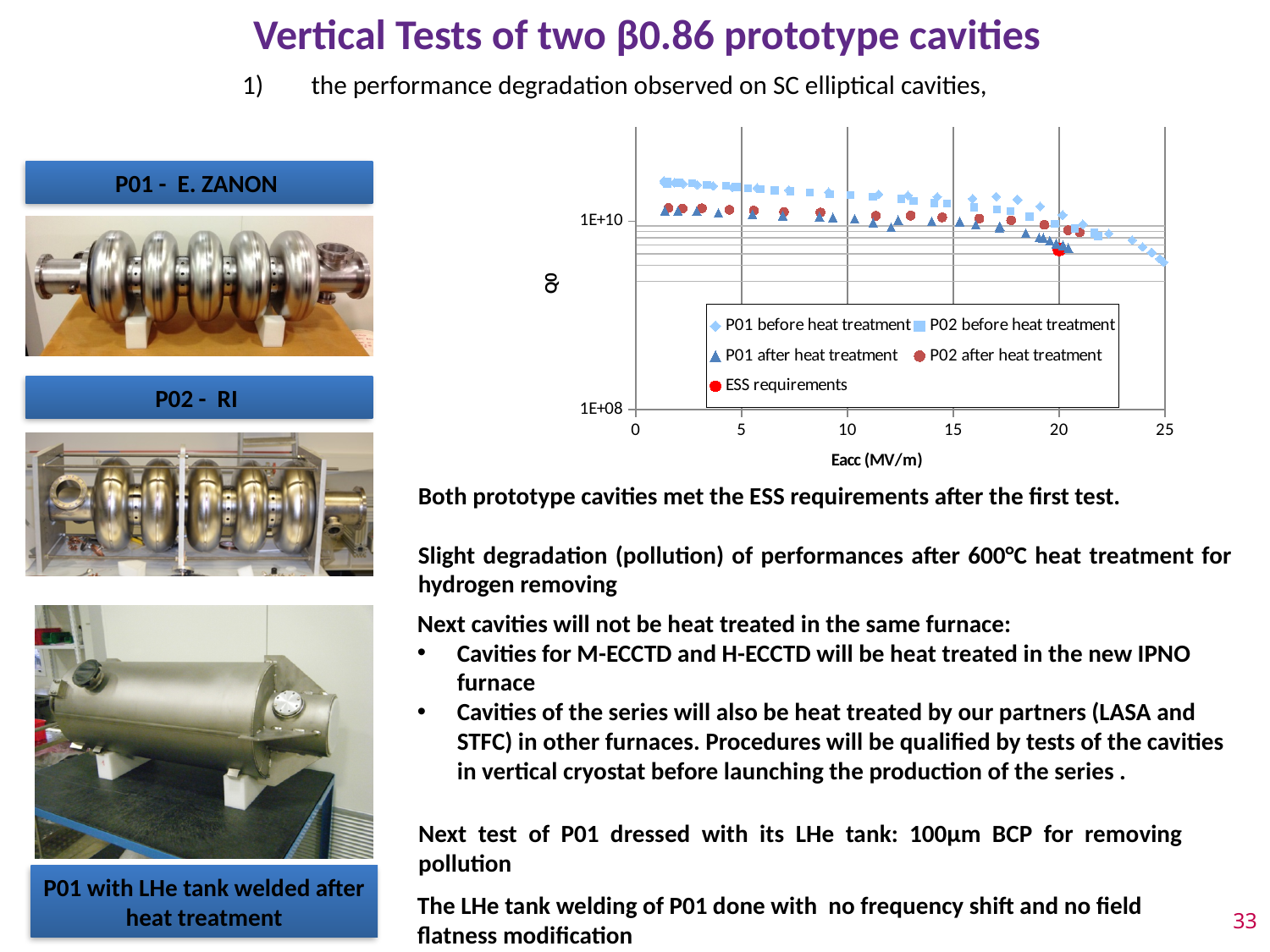
Is the Q0 value of the ESS requirements point greater or less than 1E+08? greater What is the highest Eacc value shown on the x axis of the chart? 25 At Eacc around 10 MV/m, which series has the higher Q0: P02 before heat treatment or P02 after heat treatment? P02 before heat treatment What is the label of the y axis of the chart? Q0 What kind of chart is shown on the slide? scatter chart What is the label of the x axis of the chart? Eacc (MV/m) Does Q0 rise or fall as Eacc increases for the P01 before heat treatment series? fall Is the Q0 value of the P01 before heat treatment series at Eacc 5 MV/m greater or less than 1E+10? greater At Eacc around 5 MV/m, which series has the higher Q0: P01 before heat treatment or P01 after heat treatment? P01 before heat treatment Is the Q0 value of the ESS requirements point greater or less than 1E+10? less How many series does the chart legend list? 5